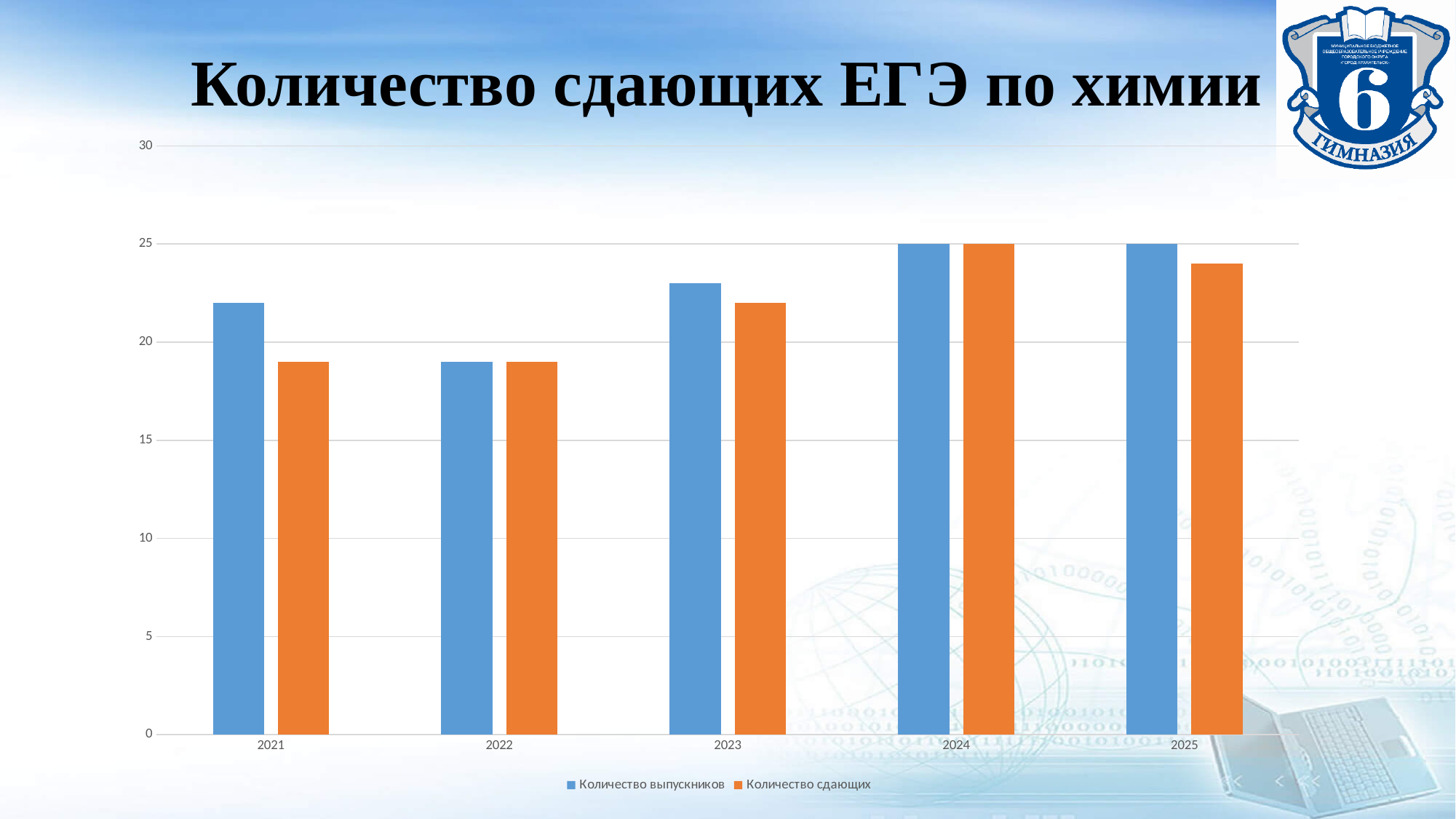
Which is larger in 2021, Количество выпускников or Количество сдающих? Количество выпускников What is the value of Количество выпускников for 2024? 25 What is the title of the chart? Количество сдающих ЕГЭ по химии How many series does the legend list? 2 Is the value of Количество сдающих for 2021 greater or less than 20? less Is the value of Количество выпускников for 2021 greater or less than 20? greater What is the value of Количество сдающих for 2024? 25 Which year has the lowest value of Количество выпускников? 2022 What is the value of Количество выпускников for 2025? 25 How many years are shown on the x axis? 5 Is the value of Количество выпускников for 2022 greater or less than 20? less What kind of chart is shown on the slide? bar chart